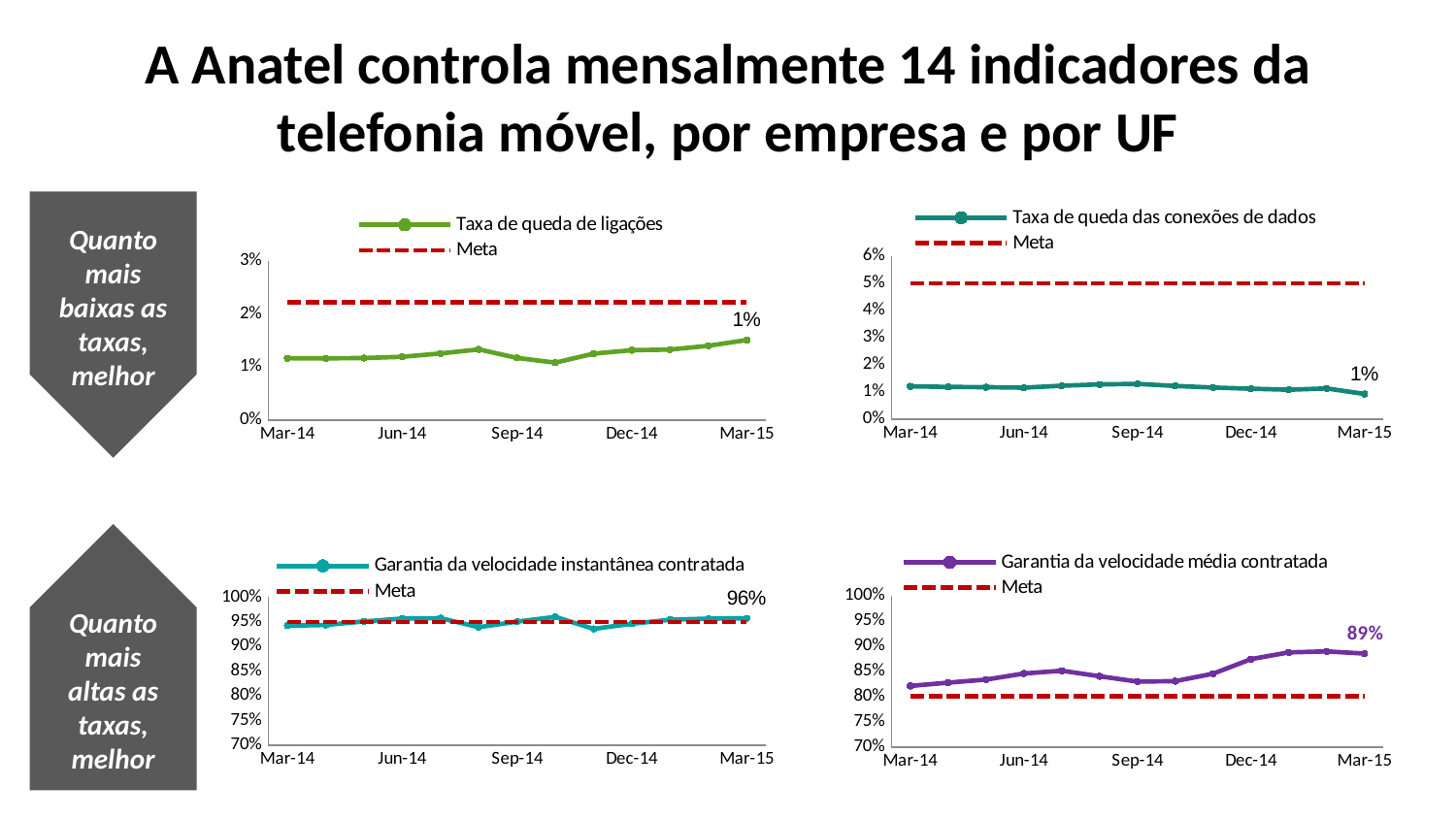
How many charts are shown on the slide? 4 In the chart 'Garantia da velocidade instantânea contratada', what is the value labelled at Mar-15? 96% In the top-left chart ('Taxa de queda de ligações'), is the value at Mar-14 greater or less than 2%? less In the bottom-right chart, which is larger at Mar-15: the 'Garantia da velocidade média contratada' series or the Meta line? Garantia da velocidade média contratada In the bottom-left chart ('Garantia da velocidade instantânea contratada'), is the Meta line greater or less than 90%? greater How many series does the legend of the top-left chart ('Taxa de queda de ligações') list? 2 What kind of chart is the bottom-right chart ('Garantia da velocidade média contratada')? line chart In the chart 'Taxa de queda de ligações', what is the value labelled at Mar-15? 1% In the chart 'Garantia da velocidade média contratada', does the plotted series rise or fall from Mar-14 to Mar-15? rises In the chart 'Taxa de queda das conexões de dados', what is the value labelled at Mar-15? 1% In the top-right chart ('Taxa de queda das conexões de dados'), is the Meta line greater or less than 4%? greater In the chart 'Garantia da velocidade média contratada', what is the value labelled at Mar-15? 89%